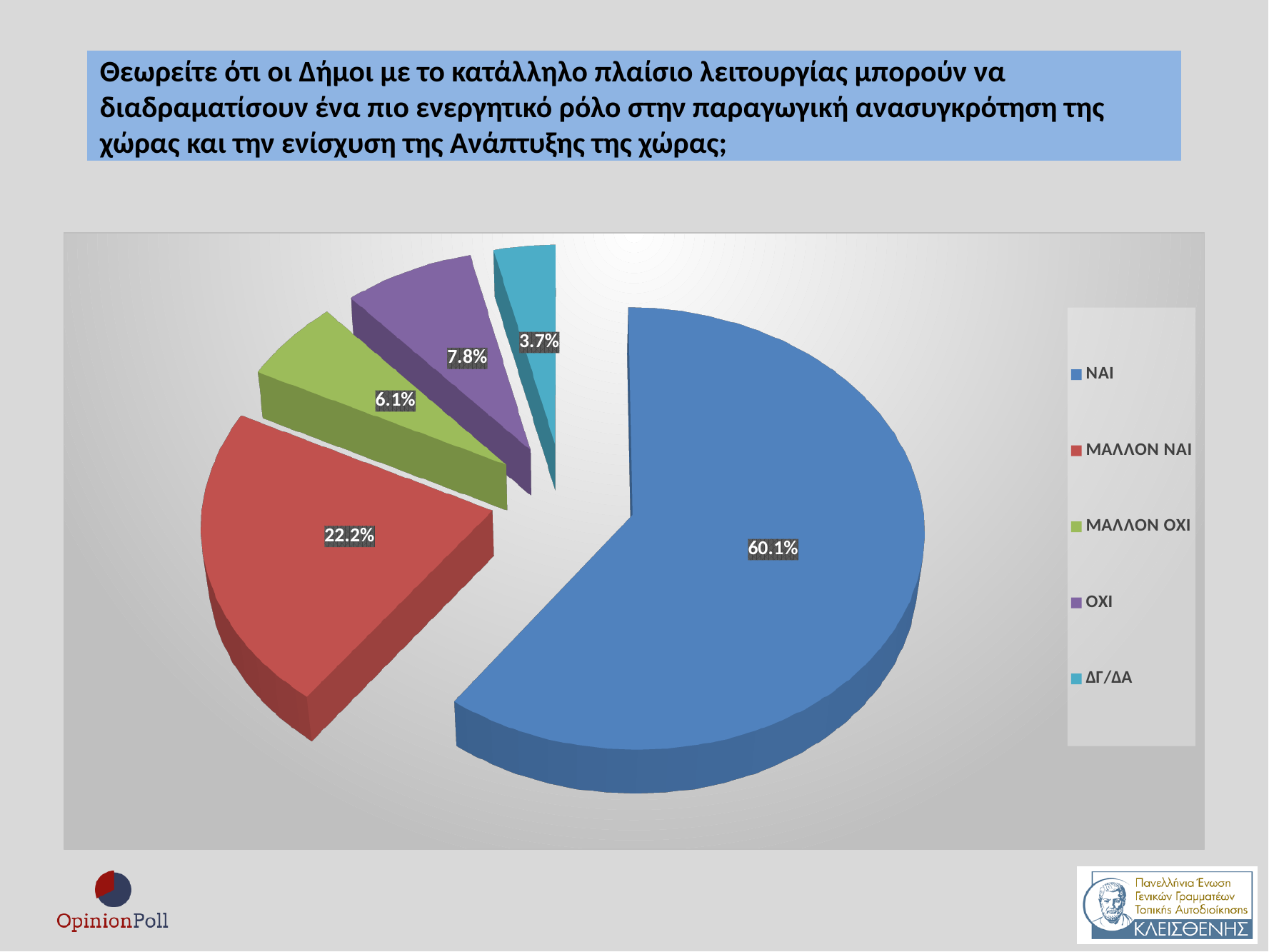
What percentage of respondents answered ΟΧΙ? 7.8% Which response has the smallest share of the pie? ΔΓ/ΔΑ How many slices does the pie chart have? 5 What percentage of respondents answered ΝΑΙ? 60.1% What percentage of respondents answered ΜΑΛΛΟΝ ΝΑΙ? 22.2% What type of chart is shown on the slide? pie chart What percentage of respondents answered ΔΓ/ΔΑ? 3.7% Which is larger, the share for ΟΧΙ or the share for ΜΑΛΛΟΝ ΟΧΙ? ΟΧΙ Which response has the largest share of the pie? ΝΑΙ What is the difference in percentage points between ΝΑΙ and ΜΑΛΛΟΝ ΝΑΙ? 37.9 What percentage of respondents answered ΜΑΛΛΟΝ ΟΧΙ? 6.1% What colour is the slice for ΜΑΛΛΟΝ ΝΑΙ? red